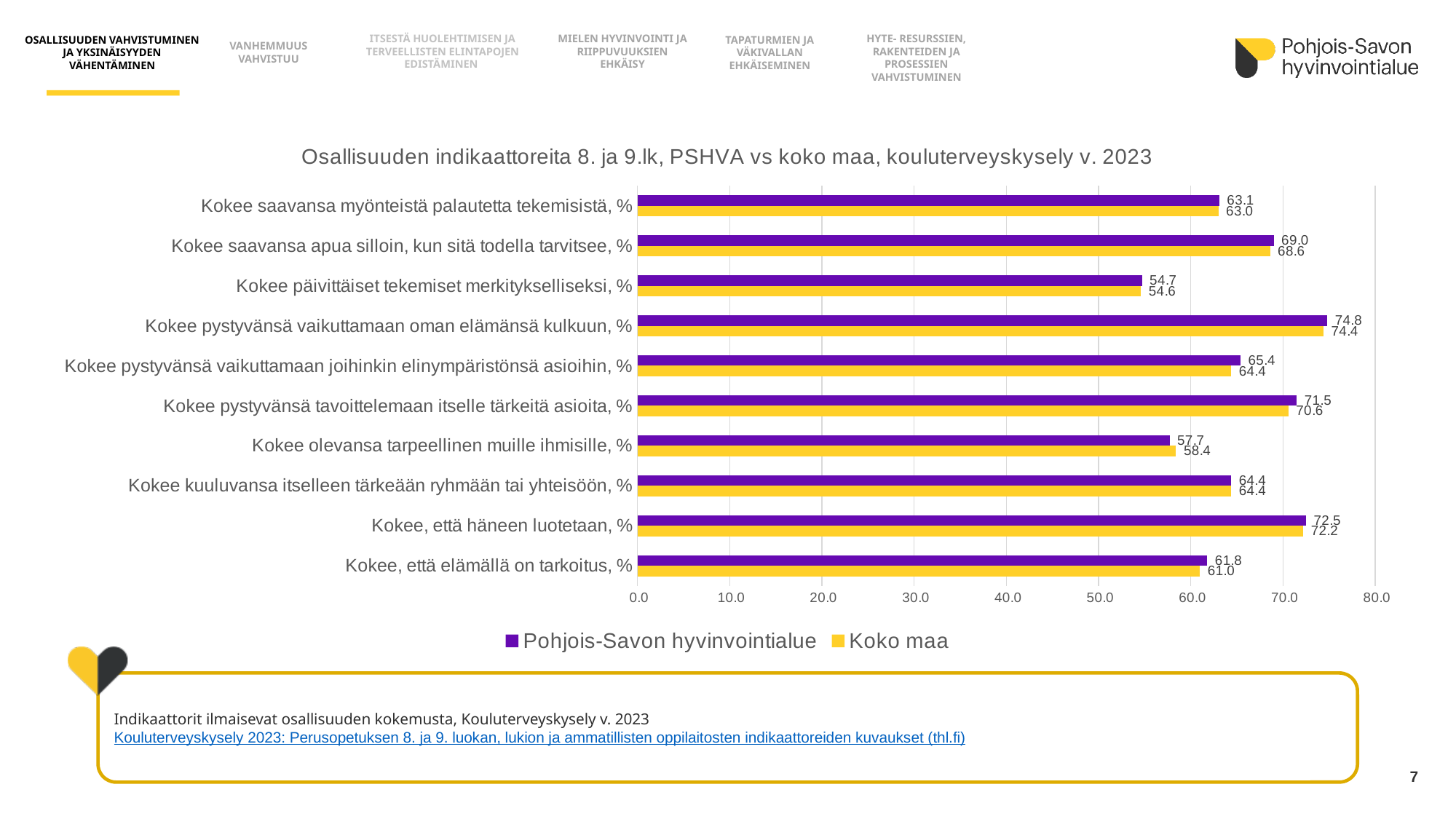
What is the value for Pohjois-Savon hyvinvointialue for "Kokee pystyvänsä vaikuttamaan oman elämänsä kulkuun, %"? 74.8 For "Kokee olevansa tarpeellinen muille ihmisille, %", which series has the larger value, Pohjois-Savon hyvinvointialue or Koko maa? Koko maa What kind of chart is shown on the slide? Bar chart What is the value for Koko maa for "Kokee, että elämällä on tarkoitus, %"? 61.0 Which category has the lowest value for Koko maa? Kokee päivittäiset tekemiset merkitykselliseksi, % What is the title of the chart? Osallisuuden indikaattoreita 8. ja 9.lk, PSHVA vs koko maa, kouluterveyskysely v. 2023 Is the Pohjois-Savon hyvinvointialue value for "Kokee, että häneen luotetaan, %" greater or less than 70.0? greater How many series does the legend list? 2 How many categories are shown in the chart? 10 What is the difference between Pohjois-Savon hyvinvointialue and Koko maa for "Kokee pystyvänsä vaikuttamaan joihinkin elinympäristönsä asioihin, %"? 1.0 Which category has the highest value for Pohjois-Savon hyvinvointialue? Kokee pystyvänsä vaikuttamaan oman elämänsä kulkuun, % What is the value for Koko maa for "Kokee olevansa tarpeellinen muille ihmisille, %"? 58.4